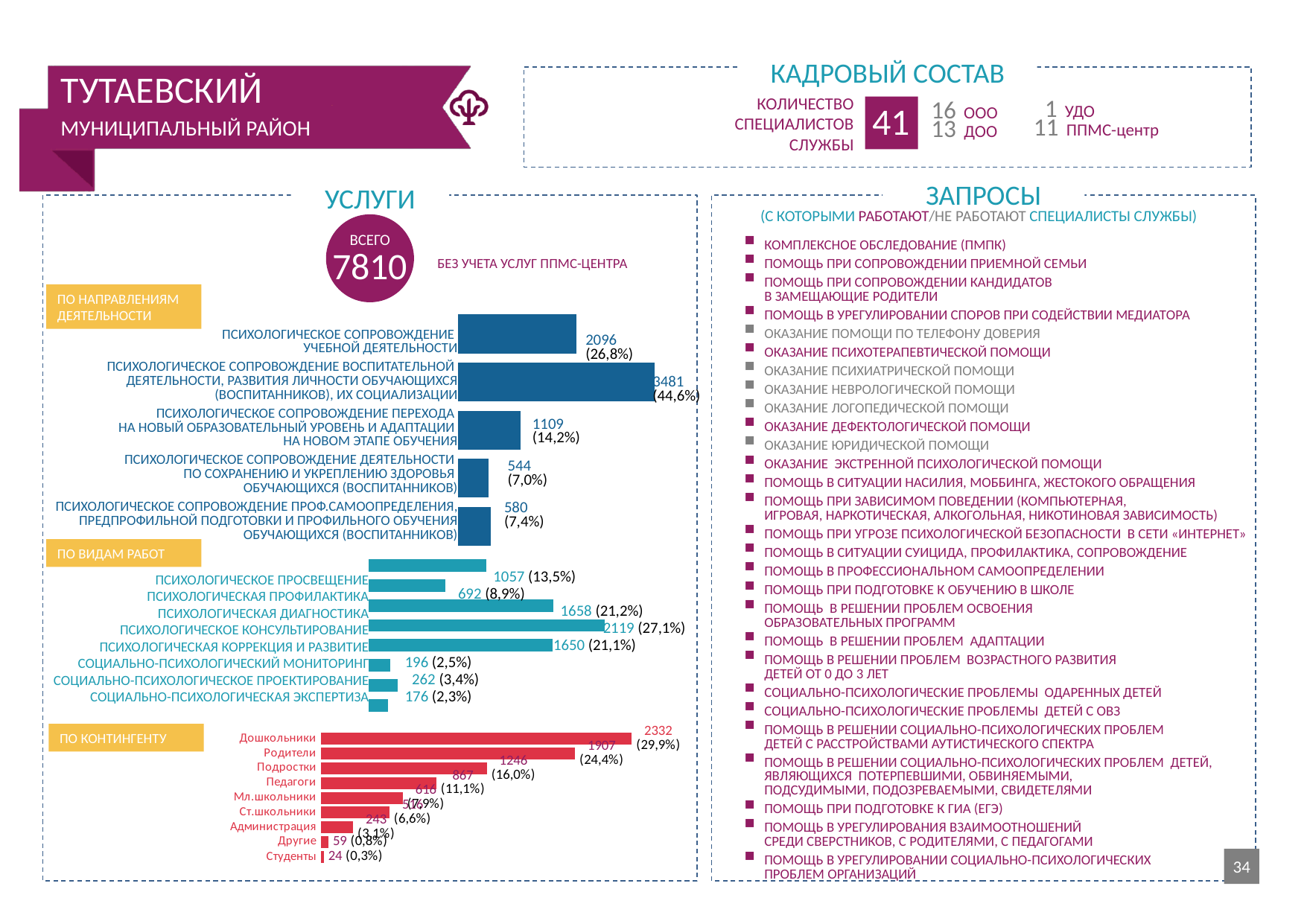
In the 'По видам работ' chart, which is larger: 'Психологическая диагностика' or 'Психологическая коррекция и развитие'? Психологическая диагностика In the 'По контингенту' chart, what is the difference between the values for 'Дошкольники' and 'Подростки'? 1086 In the 'По видам работ' chart, what is the value for 'Психологическое консультирование'? 2119 (27,1%) In the 'По направлениям деятельности' chart, what is the value for 'Психологическое сопровождение учебной деятельности'? 2096 (26,8%) In the 'По контингенту' chart, which category has the highest value? Дошкольники How many categories are shown in the 'По видам работ' chart? 8 In the 'По направлениям деятельности' chart, which category has the highest value? Психологическое сопровождение воспитательной деятельности, развития личности обучающихся (воспитанников), их социализации What type of chart is the 'По контингенту' chart? Bar chart In the 'По контингенту' chart, what is the value for 'Родители'? 1907 (24,4%) In the 'По видам работ' chart, which category has the lowest value? Социально-психологическая экспертиза How many categories are shown in the 'По направлениям деятельности' chart? 5 In the 'По направлениям деятельности' chart, what is the difference between the values for 'Психологическое сопровождение учебной деятельности' and 'Психологическое сопровождение перехода на новый образовательный уровень и адаптации на новом этапе обучения'? 987